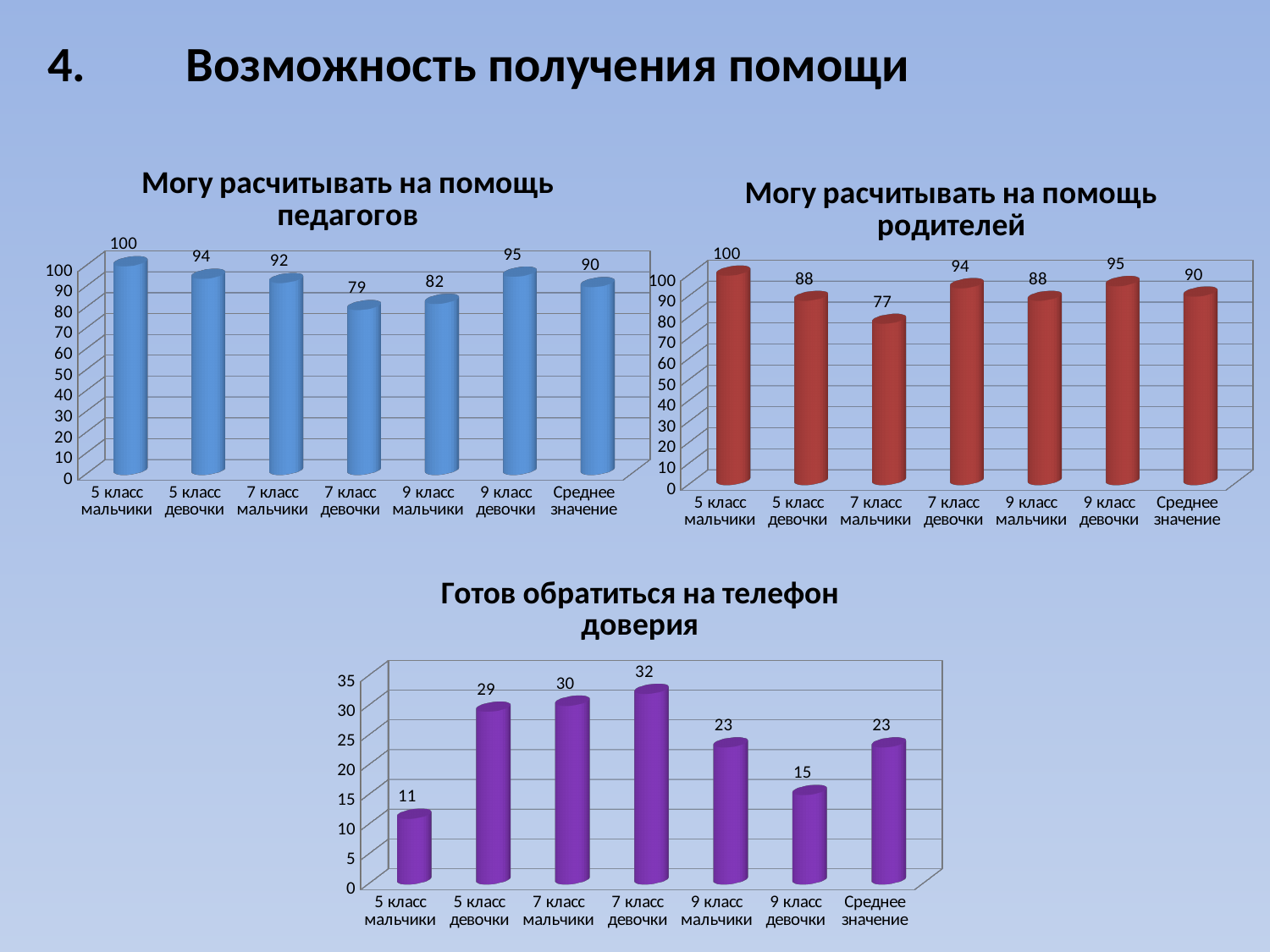
In the chart 'Готов обратиться на телефон доверия', which category has the highest value? 7 класс девочки In the chart 'Могу расчитывать на помощь родителей', which category has the highest value? 5 класс мальчики In the chart 'Готов обратиться на телефон доверия', what is the difference between '7 класс девочки' and '5 класс мальчики'? 21 What colour are the bars in the chart 'Готов обратиться на телефон доверия'? Purple In the chart 'Готов обратиться на телефон доверия', what is the value for '9 класс девочки'? 15 In the chart 'Могу расчитывать на помощь педагогов', what is the value for '7 класс девочки'? 79 In the chart 'Могу расчитывать на помощь родителей', which is larger: '7 класс девочки' or '9 класс мальчики'? 7 класс девочки What type of chart is 'Могу расчитывать на помощь родителей'? Bar chart In the chart 'Могу расчитывать на помощь педагогов', what is the difference between '5 класс мальчики' and 'Среднее значение'? 10 How many categories are shown in the chart 'Готов обратиться на телефон доверия'? 7 In the chart 'Могу расчитывать на помощь родителей', what is the value for '7 класс мальчики'? 77 In the chart 'Могу расчитывать на помощь педагогов', which category has the lowest value? 7 класс девочки